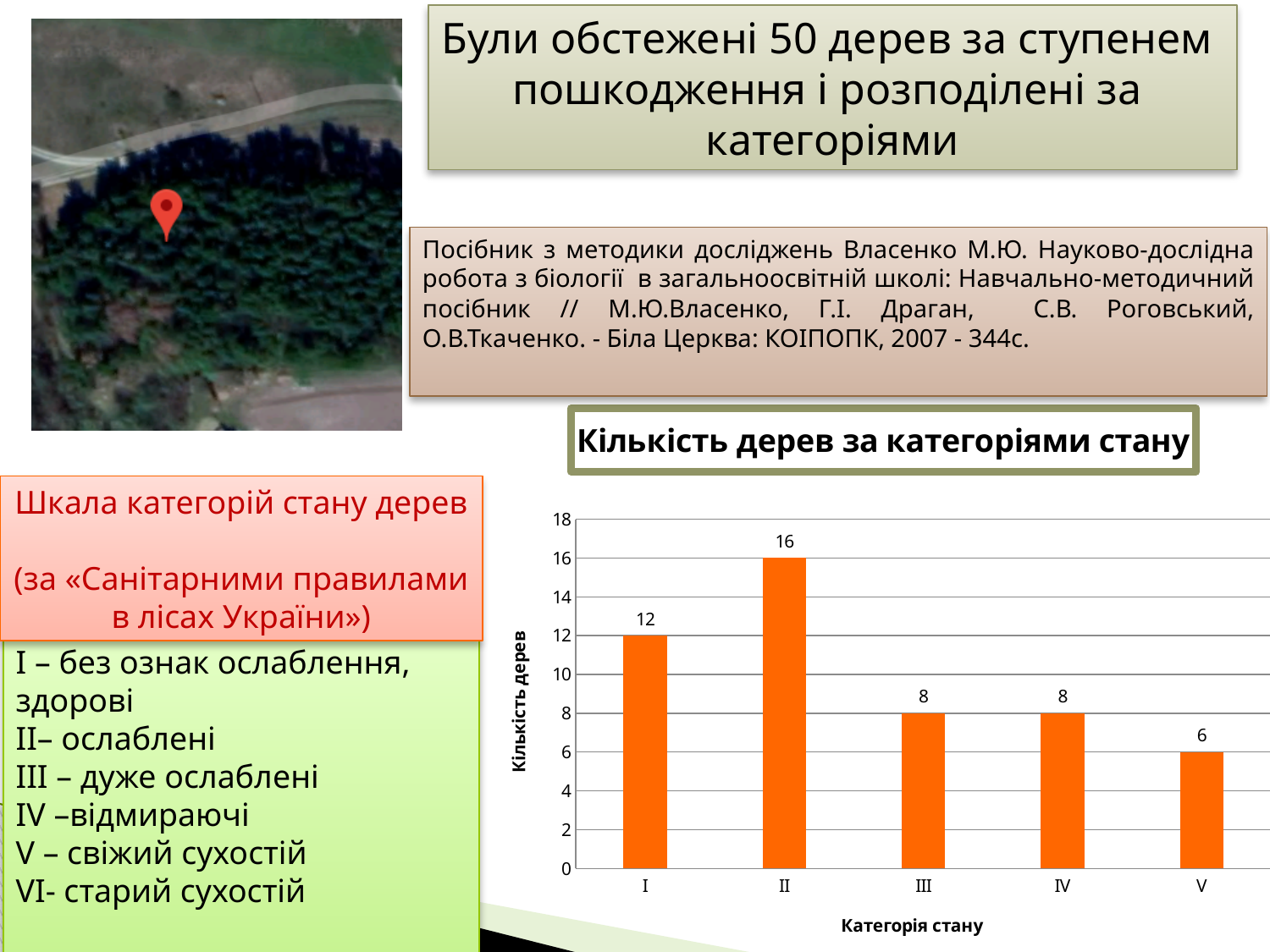
What is the difference between the values for category II and category I? 4 Is the value for category II greater or less than 14? greater Which category has the lowest number of trees in the chart? V How many categories are shown on the x axis of the chart? 5 What is the value for category II in the chart 'Кількість дерев за категоріями стану'? 16 What kind of chart is shown on the slide? bar chart What is the difference between the values for category III and category V? 2 What is the label of the y axis of the chart? Кількість дерев What is the value for category I in the chart? 12 What is the value for category V in the chart? 6 Which is larger, the value for category I or the value for category IV? I Which category has the highest number of trees in the chart? II